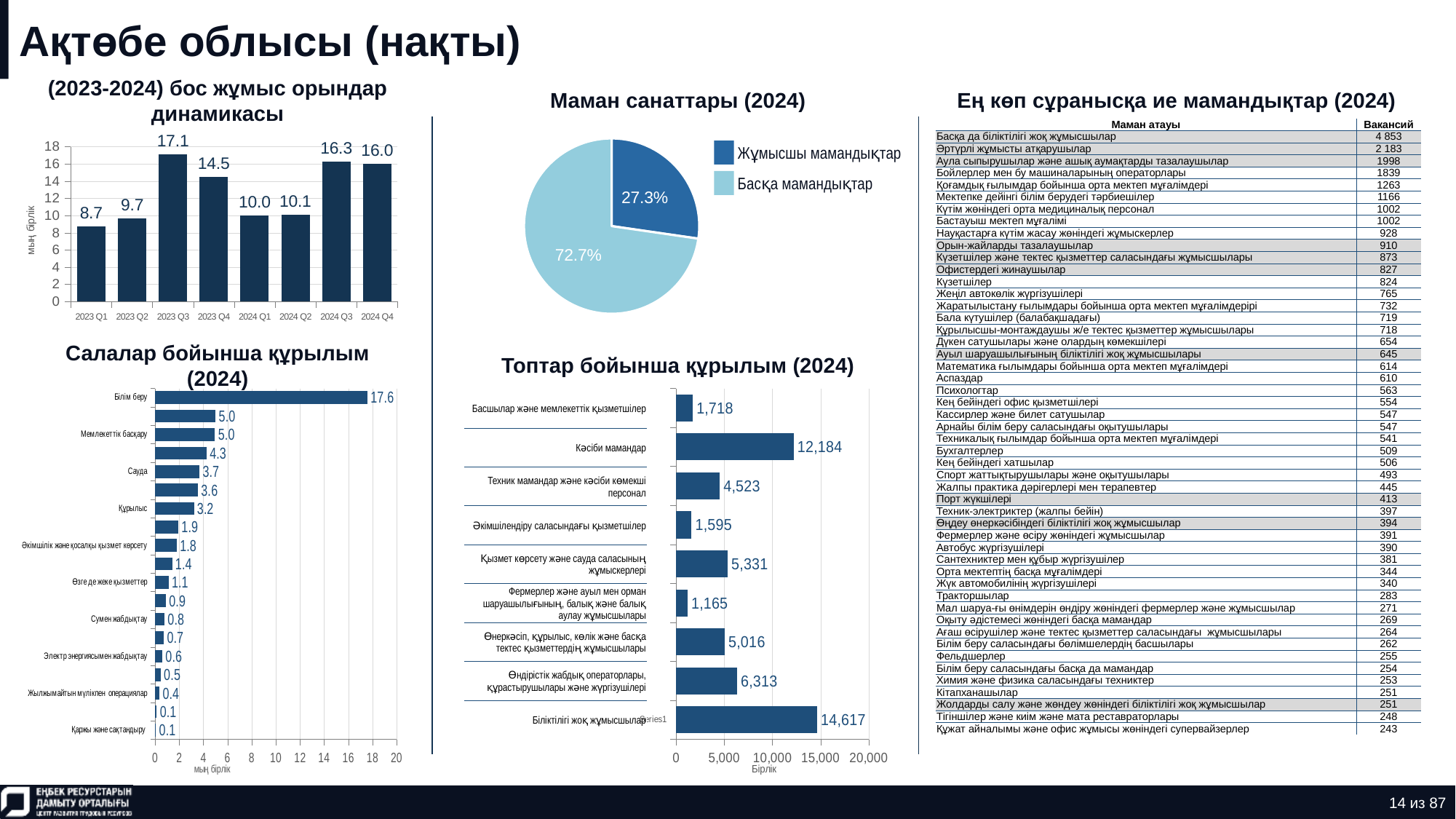
In the chart '(2023-2024) бос жұмыс орындар динамикасы', what is the difference between 2024 Q3 and 2024 Q2? 6.2 In the pie chart 'Маман санаттары (2024)', what share is Жұмысшы мамандықтар? 27.3% In the chart 'Топтар бойынша құрылым (2024)', which category has the highest value? Біліктілігі жоқ жұмысшылар In the chart '(2023-2024) бос жұмыс орындар динамикасы', which quarter has the lowest value? 2023 Q1 In the chart 'Топтар бойынша құрылым (2024)', what is the value for Кәсіби мамандар? 12,184 In the pie chart 'Маман санаттары (2024)', how many series does the legend list? 2 In the chart '(2023-2024) бос жұмыс орындар динамикасы', how many quarters are plotted? 8 What kind of chart is 'Маман санаттары (2024)'? Pie chart In the chart '(2023-2024) бос жұмыс орындар динамикасы', what is the value for 2023 Q3? 17.1 In the chart 'Салалар бойынша құрылым (2024)', what is the value for Білім беру? 17.6 In the chart '(2023-2024) бос жұмыс орындар динамикасы', which is larger: 2023 Q4 or 2024 Q4? 2024 Q4 In the chart 'Топтар бойынша құрылым (2024)', how many categories are plotted? 9